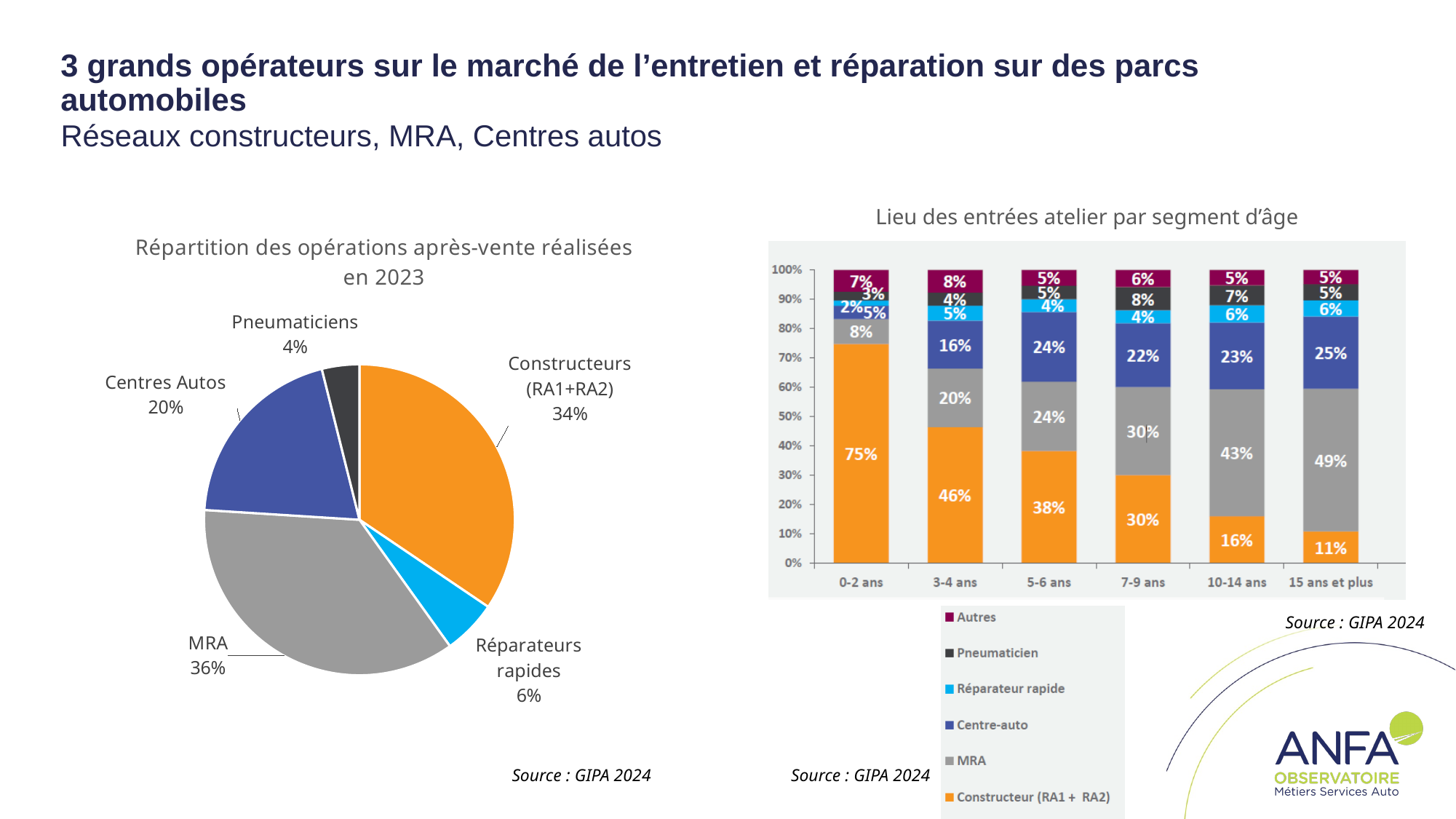
In the chart 'Lieu des entrées atelier par segment d'âge', what is the difference between the MRA value for 10-14 ans and the Constructeur (RA1 + RA2) value for 10-14 ans? 27% In the pie chart 'Répartition des opérations après-vente réalisées en 2023', what share is MRA? 36% In the pie chart 'Répartition des opérations après-vente réalisées en 2023', what is the difference between the MRA share and the Constructeurs (RA1+RA2) share? 2% In the chart 'Lieu des entrées atelier par segment d'âge', which age segment has the highest Constructeur (RA1 + RA2) value? 0-2 ans In the chart 'Lieu des entrées atelier par segment d'âge', how does the Constructeur (RA1 + RA2) share change as the age segments increase from 0-2 ans to 15 ans et plus? It falls In the pie chart 'Répartition des opérations après-vente réalisées en 2023', which is larger: Centres Autos or Réparateurs rapides? Centres Autos What type of chart is 'Lieu des entrées atelier par segment d'âge'? Stacked bar chart In the pie chart 'Répartition des opérations après-vente réalisées en 2023', how many slices are there? 5 In the chart 'Lieu des entrées atelier par segment d'âge', how many series does the legend list? 6 In the chart 'Lieu des entrées atelier par segment d'âge', what is the Constructeur (RA1 + RA2) value for 0-2 ans? 75% In the chart 'Lieu des entrées atelier par segment d'âge', what is the MRA value for 15 ans et plus? 49% In the pie chart 'Répartition des opérations après-vente réalisées en 2023', which category has the smallest share? Pneumaticiens